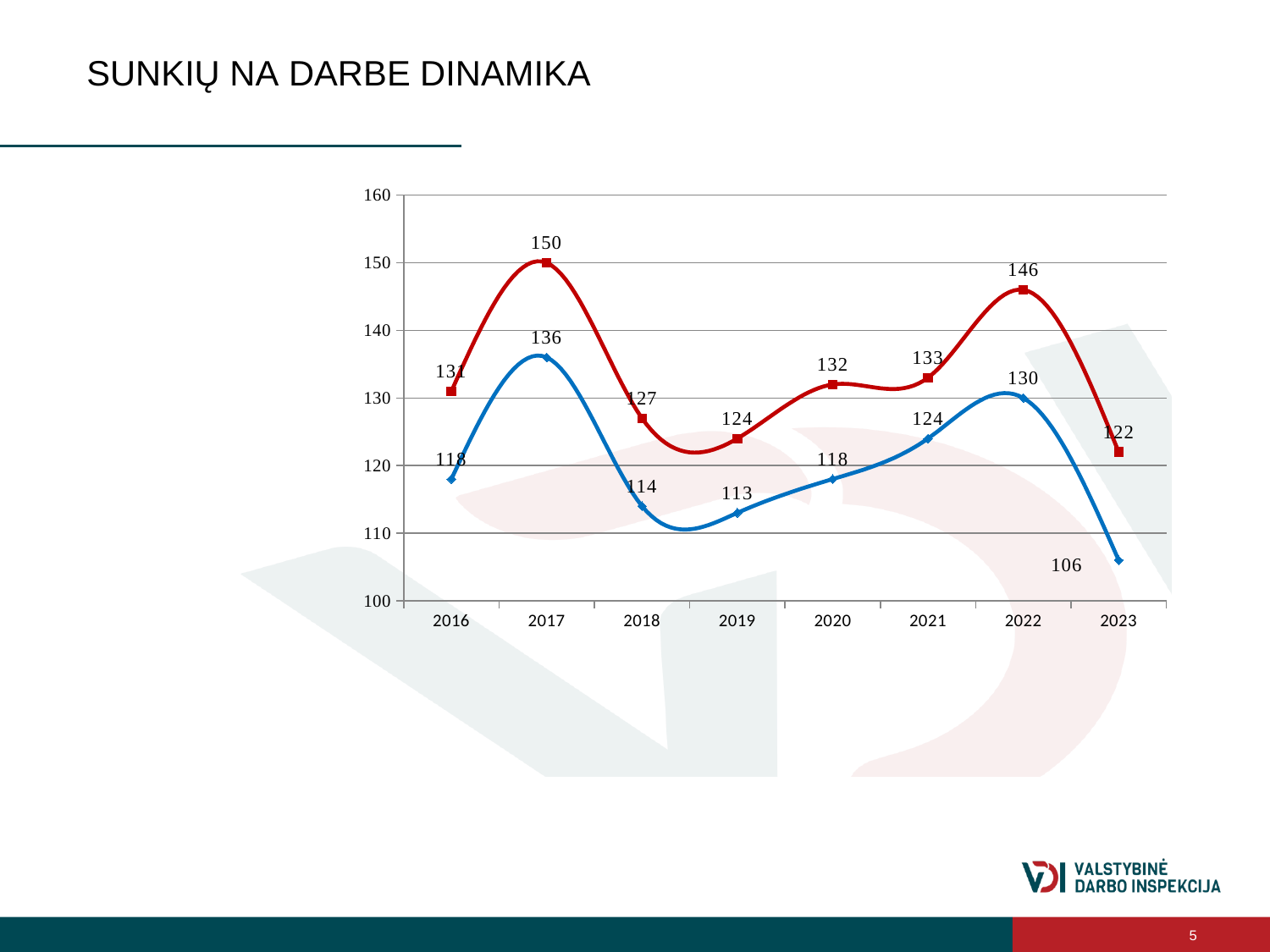
What is the value of the red line in 2017? 150 What kind of chart is shown on the slide? line chart What is the value of the red line in 2022? 146 How many years are shown on the x axis? 8 What is the value of the blue line in 2019? 113 What is the difference between the red line and the blue line in 2018? 13 Does the red line rise or fall from 2022 to 2023? fall In which year does the red line reach its highest value? 2017 Which is larger: the blue line's value in 2021 or its value in 2020? 2021 What is the value of the blue line in 2023? 106 In which year does the blue line reach its lowest value? 2023 How many lines are plotted on the chart? 2